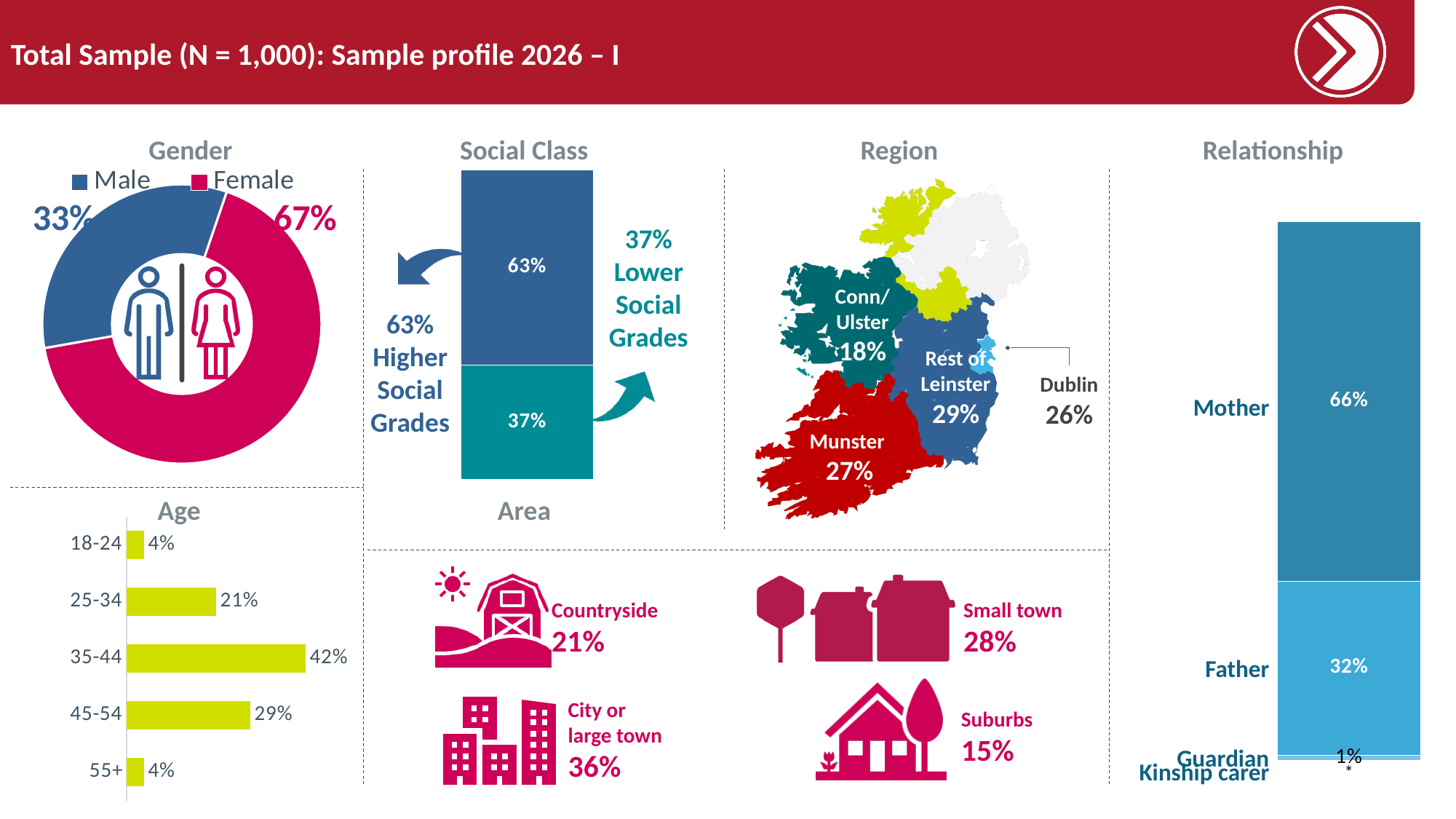
In the Area section, which is larger: Countryside or Small town? Small town In the Region map, which region has the lowest percentage? Conn/Ulster In the Social Class chart, what percentage is Higher Social Grades? 63% How many age groups are shown in the Age chart? 5 In the Gender chart, what percentage of the sample is Male? 33% In the Relationship chart, what percentage are Father? 32% In the Age chart, what is the value for the 45-54 age group? 29% In the Age chart, which age group has the highest percentage? 35-44 In the Gender chart, what percentage of the sample is Female? 67% In the Age chart, what is the difference between the 35-44 and 25-34 groups? 21% What kind of chart is the Age chart? Bar chart What kind of chart is the Gender chart? Donut (pie) chart